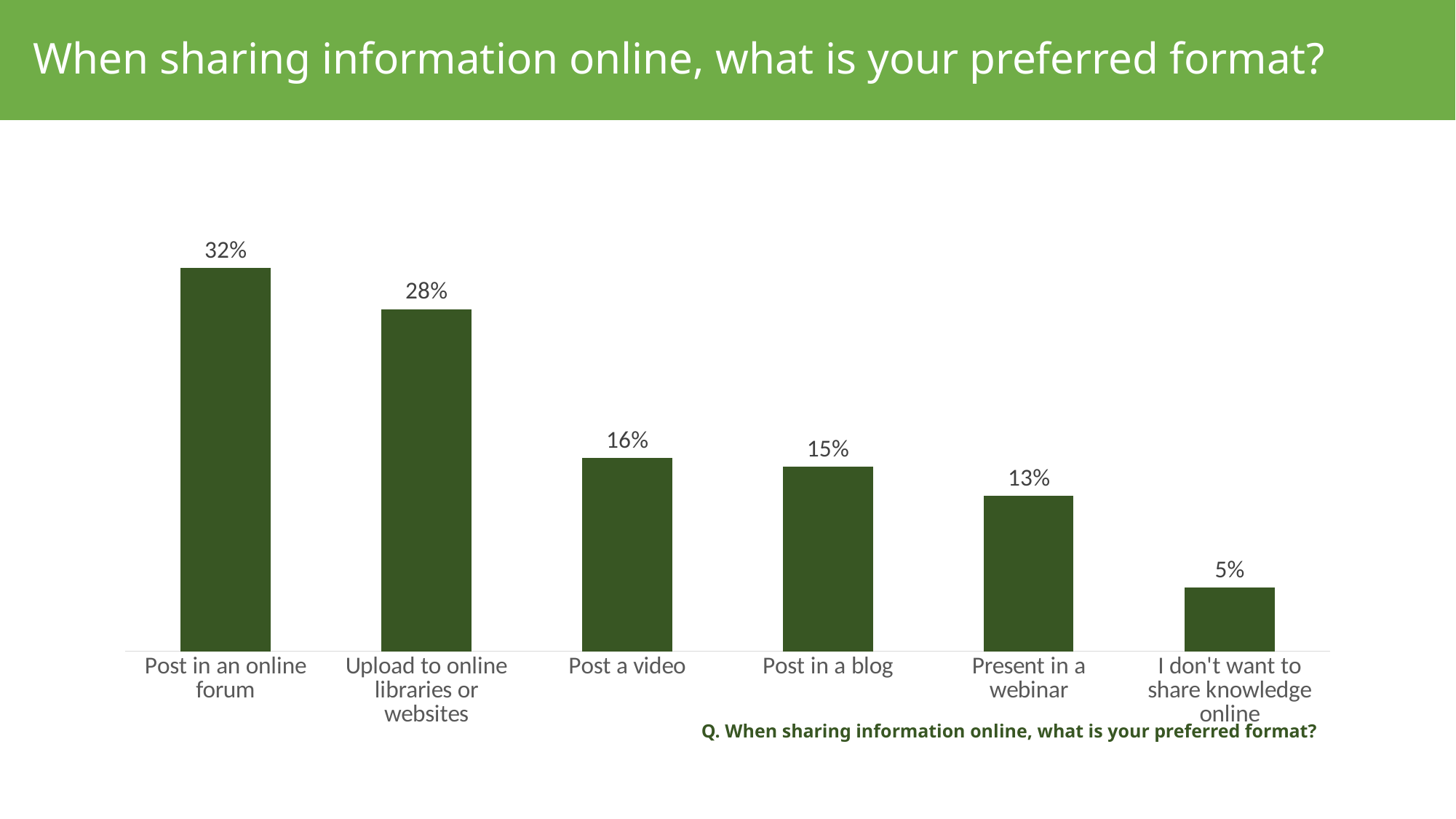
Which category has the lowest value? I don't want to share knowledge online How many categories are shown in the chart? 6 Which format has the highest percentage? Post in an online forum What is the difference between 'Post in an online forum' and 'Upload to online libraries or websites'? 4% What percentage of respondents prefer to post in an online forum? 32% What kind of chart is shown on the slide? Bar chart Do the values rise or fall from left to right across the categories? Fall What is the value for 'Present in a webinar'? 13% What percentage prefer to post a video? 16% Which is larger, 'Post in a blog' or 'Present in a webinar'? Post in a blog What is the difference between 'Post a video' and 'I don't want to share knowledge online'? 11% What is the value for 'Upload to online libraries or websites'? 28%